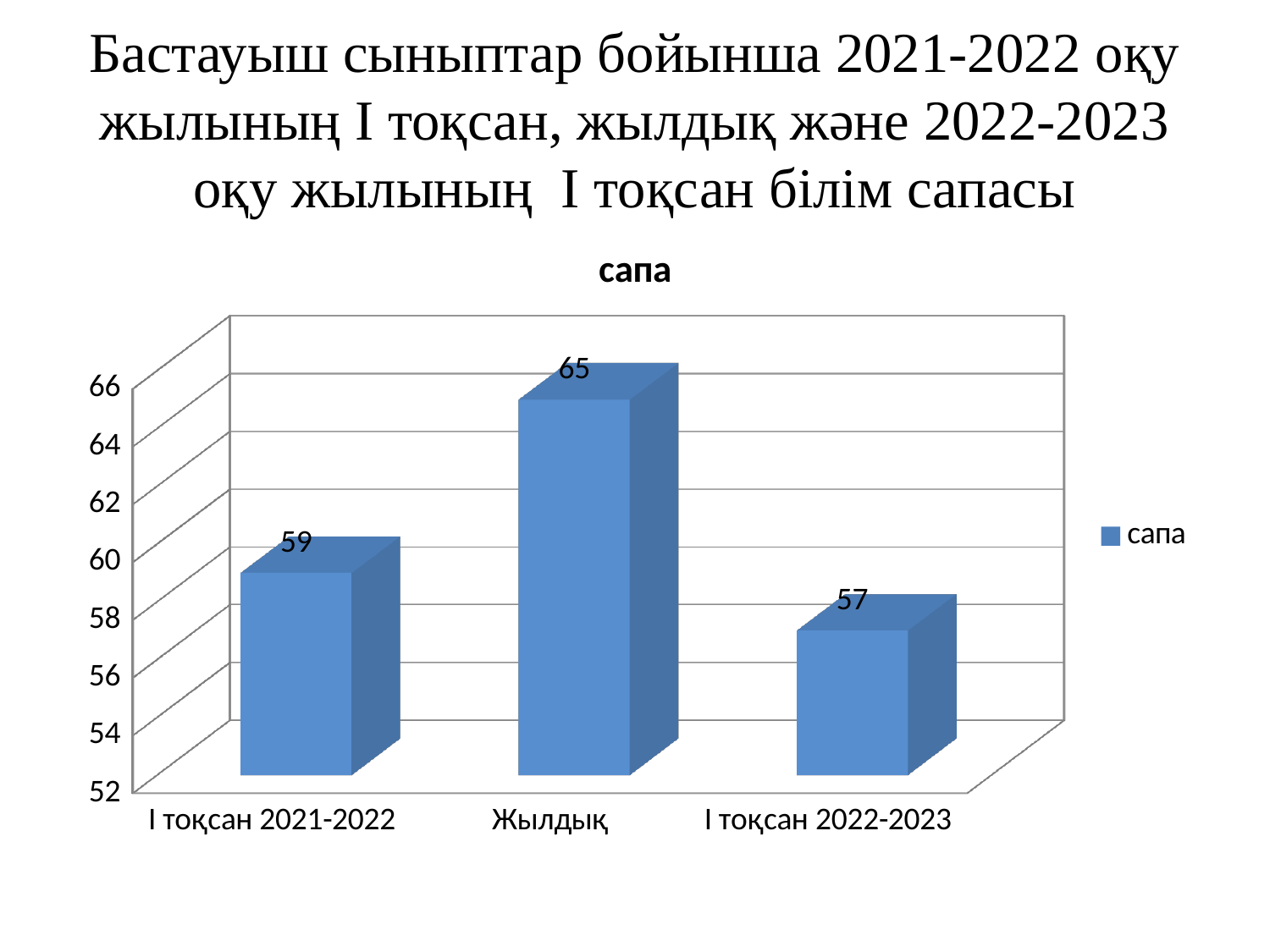
Is the value for Жылдық greater or less than 60? greater What kind of chart is shown on the slide? bar chart How many categories are shown on the x axis? 3 Which category has the highest value? Жылдық What is the difference between the values for Жылдық and I тоқсан 2022-2023? 8 What is the difference between the values for I тоқсан 2021-2022 and I тоқсан 2022-2023? 2 What is the value for Жылдық? 65 Which is larger, the value for I тоқсан 2021-2022 or the value for I тоқсан 2022-2023? I тоқсан 2021-2022 Which category has the lowest value? I тоқсан 2022-2023 What is the value for I тоқсан 2022-2023? 57 What is the value for I тоқсан 2021-2022? 59 How many series does the legend list? 1